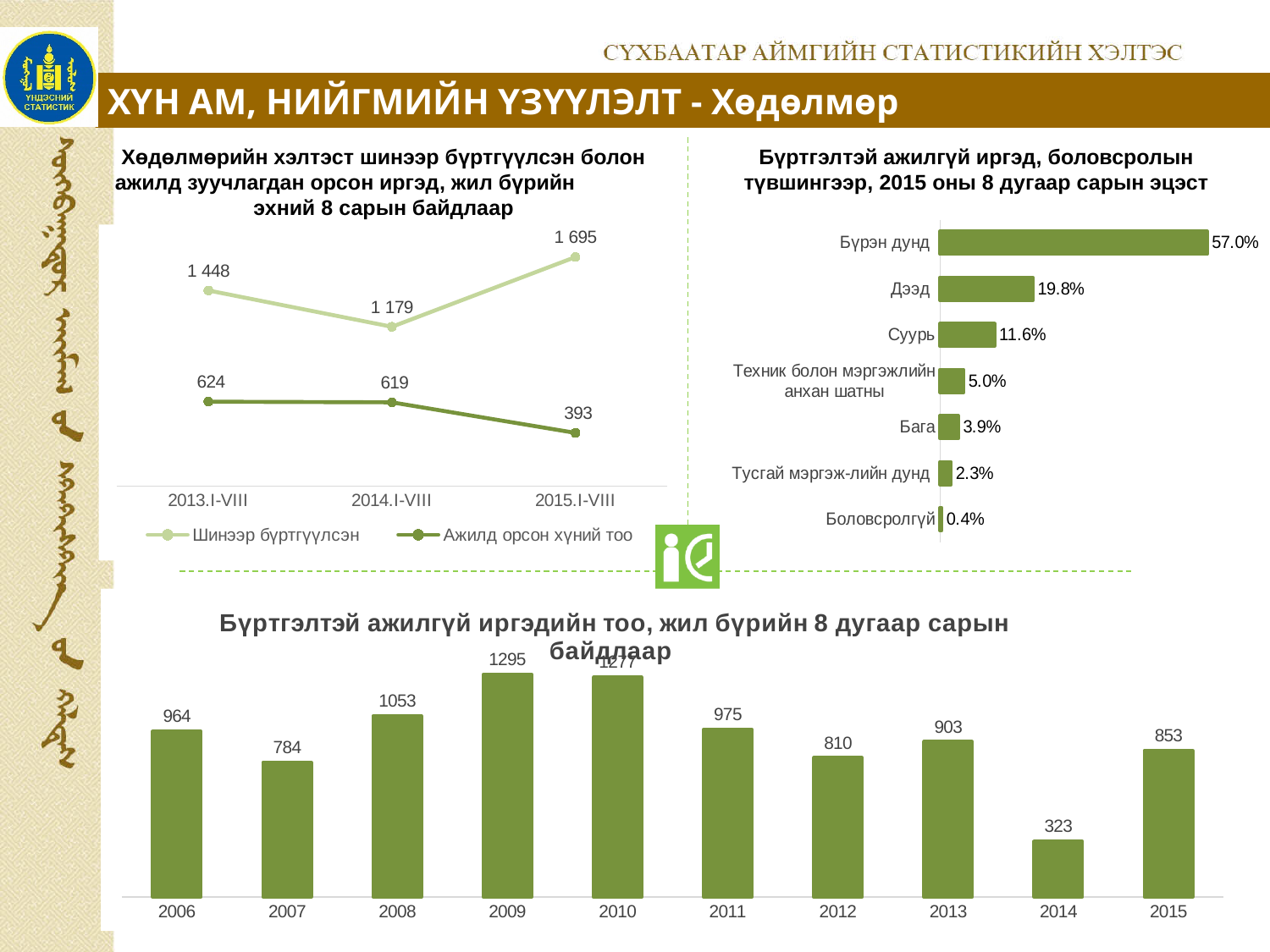
In the top-left line chart, what is the difference between Шинээр бүртгүүлсэн and Ажилд орсон хүний тоо in 2013.I-VIII? 824 In the top-right chart (Бүртгэлтэй ажилгүй иргэд, боловсролын түвшингээр), what is the value for Дээд? 19.8% In the top-left line chart, how many series does the legend list? 2 In the top-right chart (Бүртгэлтэй ажилгүй иргэд, боловсролын түвшингээр), how many categories are shown? 7 In the top-right chart (Бүртгэлтэй ажилгүй иргэд, боловсролын түвшингээр), which category has the lowest value? Боловсролгүй In the top-left line chart, what is the value for Ажилд орсон хүний тоо in 2014.I-VIII? 619 In the bottom chart (Бүртгэлтэй ажилгүй иргэдийн тоо), what is the value for 2014? 323 In the top-left line chart, what is the value for Шинээр бүртгүүлсэн in 2015.I-VIII? 1 695 In the bottom chart (Бүртгэлтэй ажилгүй иргэдийн тоо), what kind of chart is it? bar chart In the bottom chart (Бүртгэлтэй ажилгүй иргэдийн тоо), which year has the highest value? 2009 In the top-right chart (Бүртгэлтэй ажилгүй иргэд, боловсролын түвшингээр), which category has the highest value? Бүрэн дунд In the top-left line chart, does the Ажилд орсон хүний тоо series rise or fall from 2013.I-VIII to 2015.I-VIII? fall